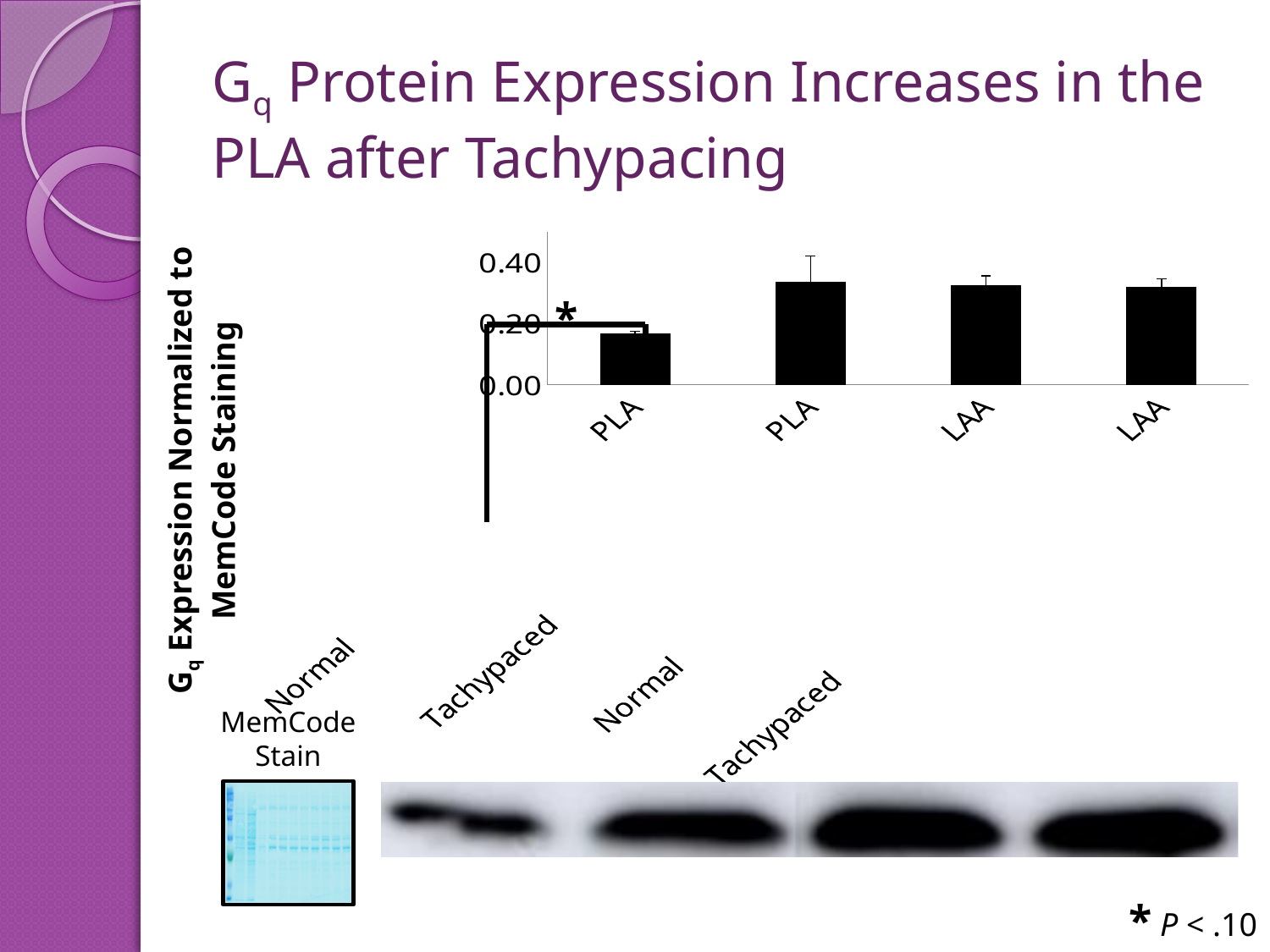
What does the asterisk (*) on the chart indicate, according to the slide? P < .10 How many bars are plotted in the chart? 4 Is the value of the first (leftmost) PLA bar greater or less than 0.20? less Which is larger, the first PLA bar or the second PLA bar? the second PLA bar Which is larger, the first (leftmost) PLA bar or the first LAA bar? the first LAA bar What kind of chart is shown on the slide? bar chart What is the highest tick value shown on the y axis of the chart? 0.40 Is the value of the second (rightmost) LAA bar greater or less than 0.20? greater Which bar in the chart is the lowest? the first (leftmost) PLA bar Is the value of the first LAA bar greater or less than 0.40? less